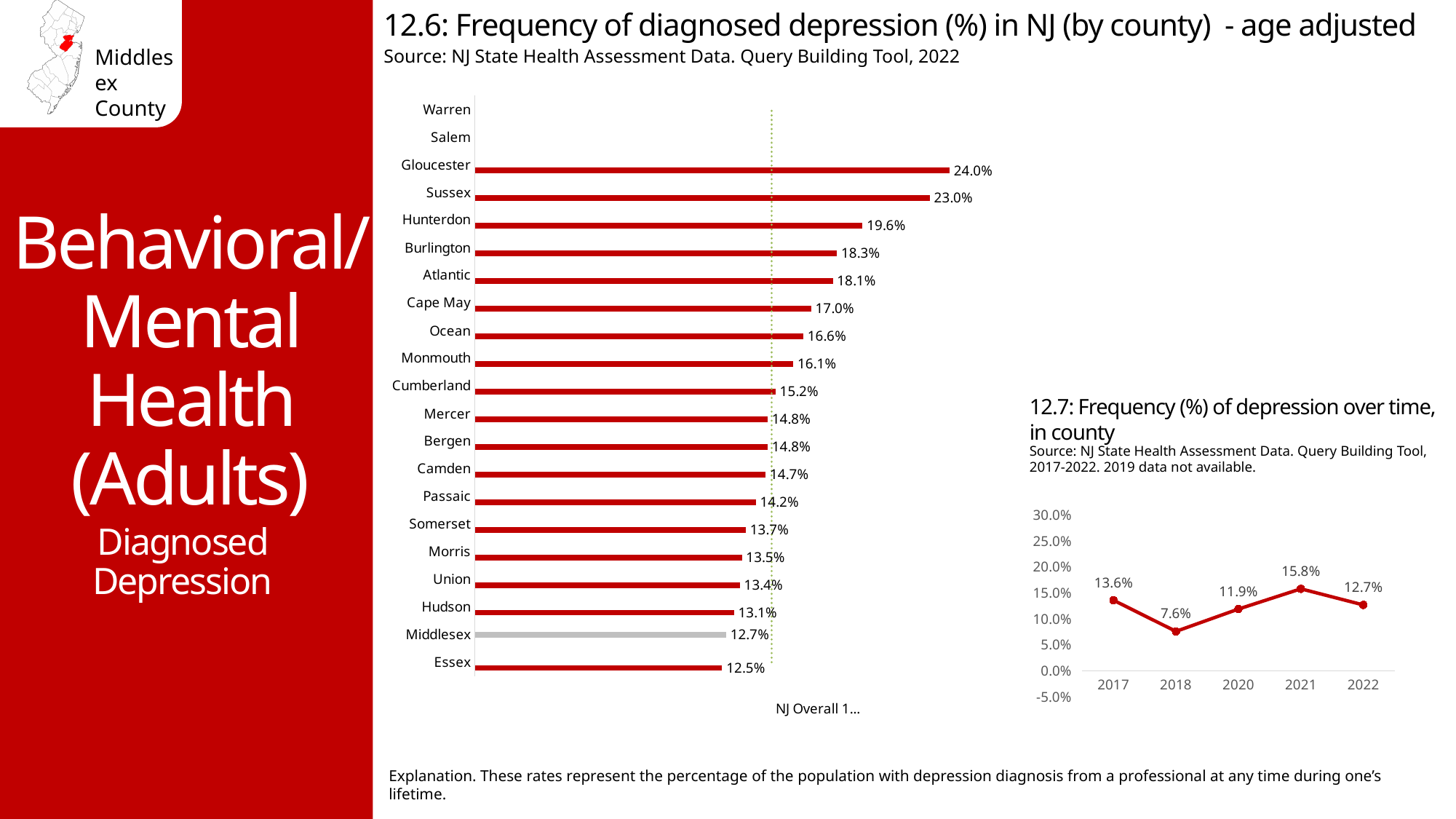
How many years are plotted in chart 12.7? 5 In chart 12.7, what is the difference between the 2021 and 2022 values? 3.1% In chart 12.6, what is the difference between the values for Gloucester and Sussex? 1.0% In chart 12.7, what is the frequency of depression in 2018? 7.6% In chart 12.6, which county with a plotted bar has the lowest frequency of diagnosed depression? Essex What kind of chart is chart 12.7? Line chart In chart 12.6, what is the value shown for Hunterdon? 19.6% In chart 12.6, which county has a higher value, Burlington or Cape May? Burlington In chart 12.6, what is the frequency of diagnosed depression for Middlesex? 12.7% In chart 12.6, which county has the highest frequency of diagnosed depression? Gloucester What kind of chart is chart 12.6? Bar chart In chart 12.7, which year has the highest frequency of depression? 2021